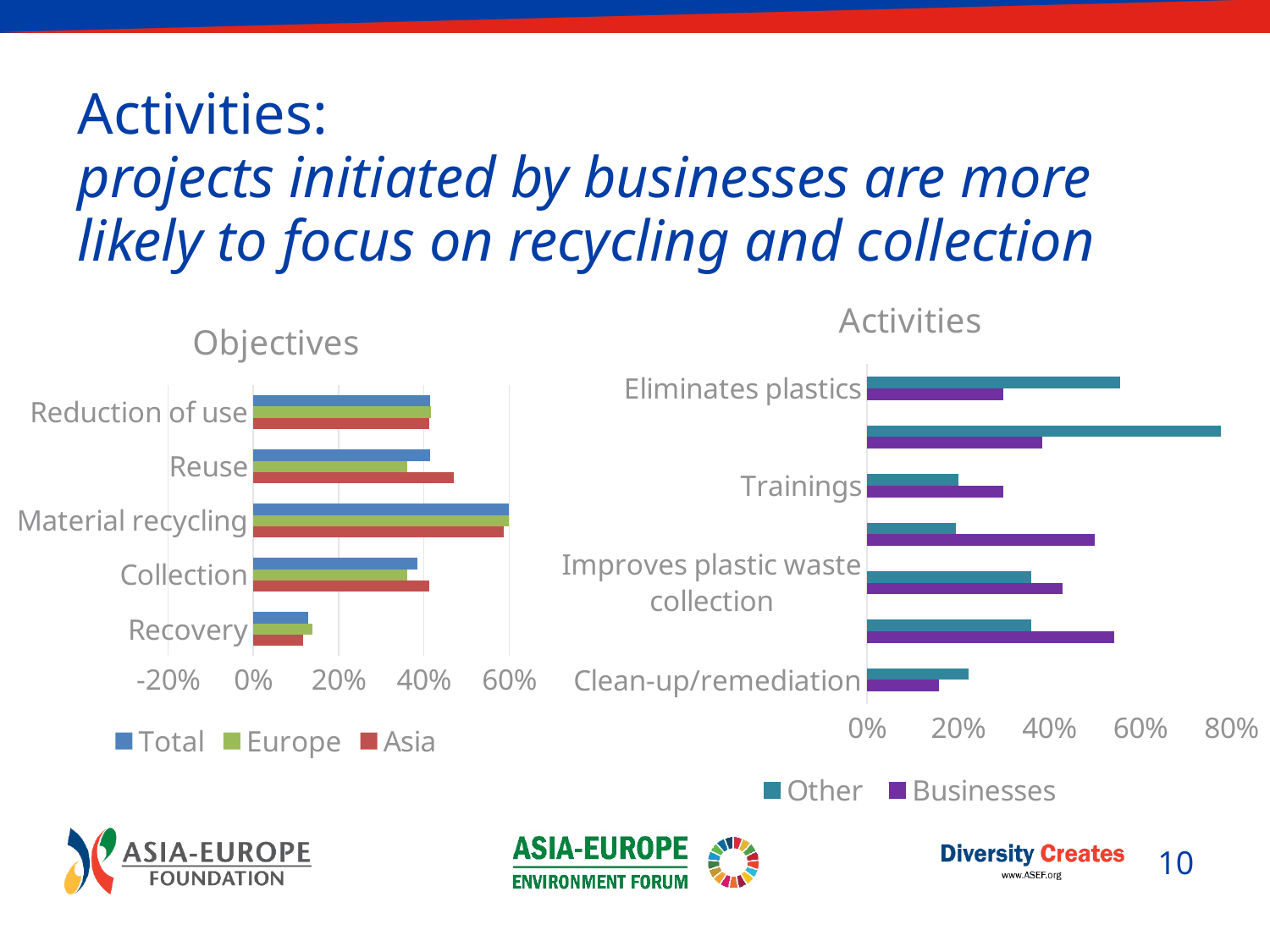
How many categories are shown on the Objectives chart? 5 In the Activities chart, is the Businesses value for Clean-up/remediation greater or less than 20%? less In the Objectives chart, which category has the highest Total value? Material recycling In the Objectives chart, is the Total value for Material recycling greater or less than 40%? greater How many series does the legend of the Objectives chart list? 3 In the Objectives chart, which category has the lowest Total value? Recovery How many series does the legend of the Activities chart list? 2 In the Activities chart, which is larger for Eliminates plastics: Other or Businesses? Other What kind of chart is the Objectives chart on the left? bar chart In the Objectives chart, is the Total value for Recovery greater or less than 20%? less In the Activities chart, which is larger for Trainings: Other or Businesses? Businesses In the Objectives chart, which is larger for Reuse: Europe or Asia? Asia